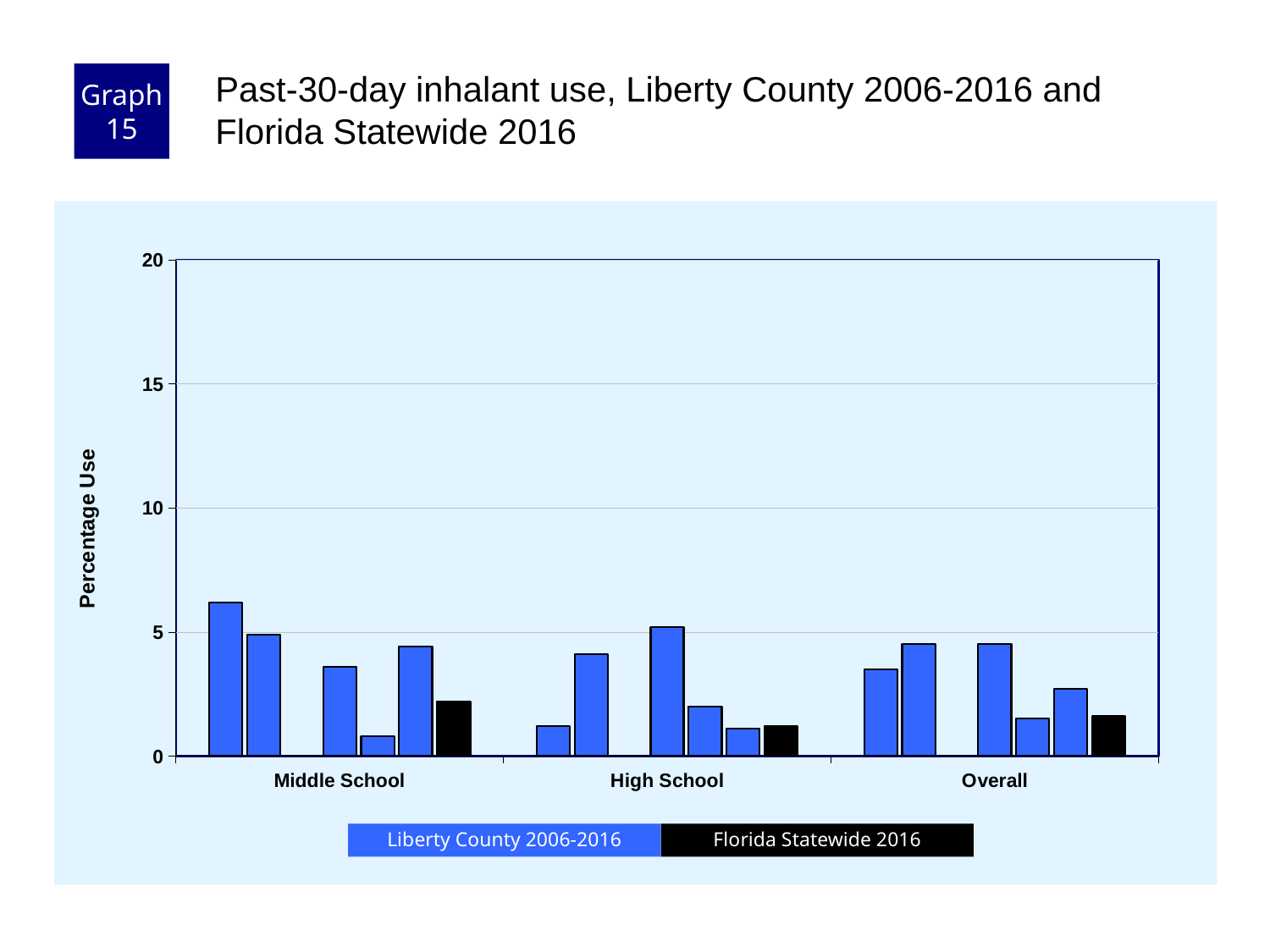
Which group has the tallest Florida Statewide 2016 bar: Middle School, High School, or Overall? Middle School How many series does the legend list? 2 How many categories are shown on the x axis? 3 Is the value for the Florida Statewide 2016 bar in the Middle School group greater or less than 5? less Which series is shown in black in the legend? Florida Statewide 2016 Which group has the lowest Florida Statewide 2016 bar? High School Which is larger: the Florida Statewide 2016 bar for Middle School or the Florida Statewide 2016 bar for High School? Middle School Is the value for the tallest Liberty County bar in the Middle School group greater or less than 5? greater Is the value for the Florida Statewide 2016 bar in the High School group greater or less than 5? less What kind of chart is shown on the slide? bar chart What is the label of the y axis? Percentage Use